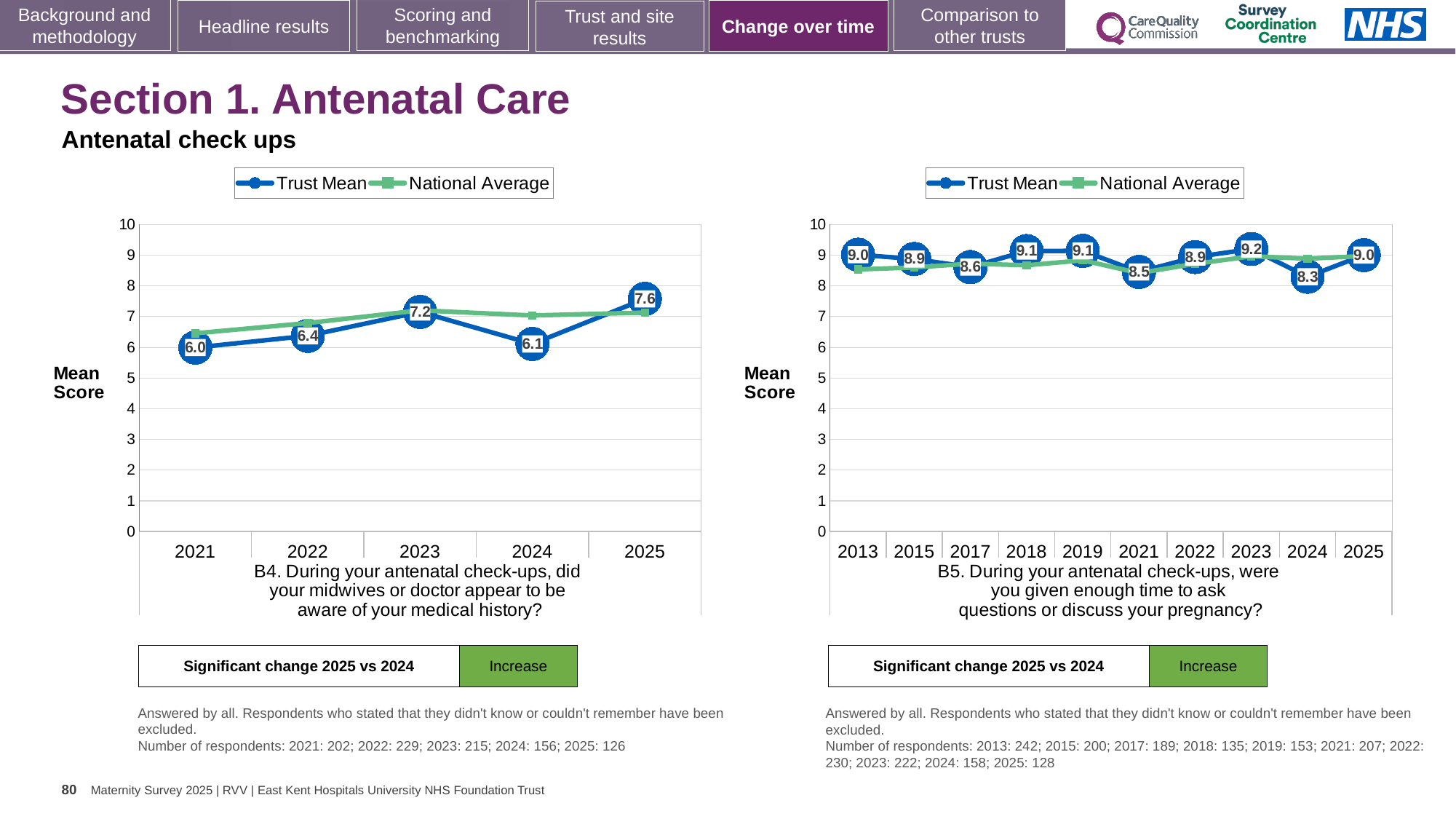
In the B4 chart (left), which year has the lowest Trust Mean score? 2021 In the B4 chart (left), what is the Trust Mean score for 2021? 6.0 In the B4 chart (left), what is the difference between the Trust Mean scores for 2025 and 2024? 1.5 In the B5 chart (right), what is the Trust Mean score for 2024? 8.3 How many series does the legend of the B5 chart (right) list? 2 In the B5 chart (right), how many years are shown on the x axis? 10 In the B4 chart (left), is the National Average for 2021 greater or less than 7? less In the B4 chart (left), what is the Trust Mean score for 2025? 7.6 In the B5 chart (right), which year has the highest Trust Mean score? 2023 In the B5 chart (right), which year has the lowest Trust Mean score? 2024 In the B5 chart (right), is the Trust Mean score for 2018 or 2021 larger? 2018 In the B4 chart (left), how many years are shown on the x axis? 5